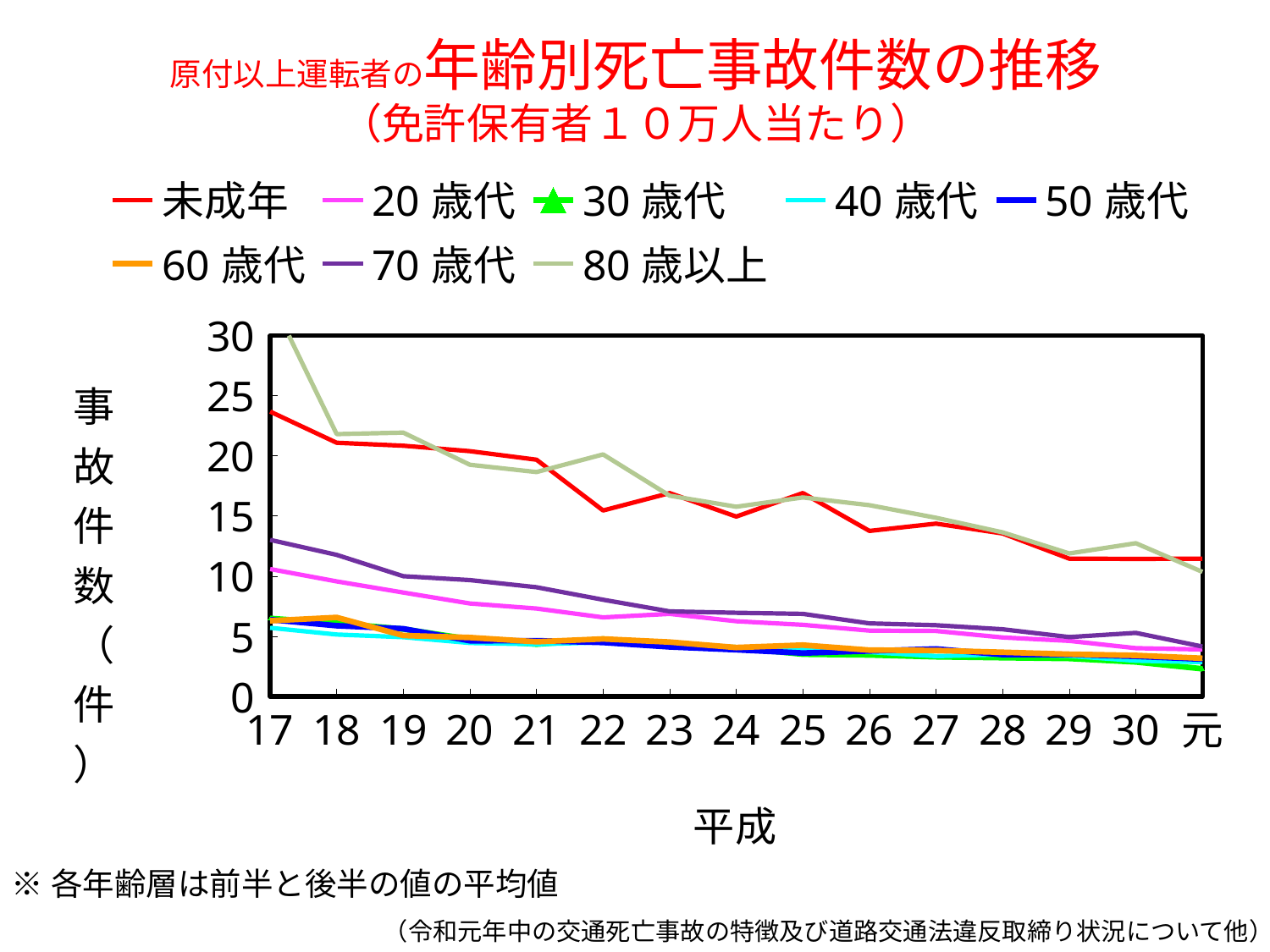
Which is larger at 17, the value for 未成年 or the value for 20歳代? 未成年 How many points are plotted along the x axis for each series? 15 Is the value for 80歳以上 at 17 greater or less than 25? greater Is the value for 70歳代 at 17 greater or less than 10? greater What kind of chart is shown on the slide? line chart Which series has the highest value at 17? 80歳以上 How many series does the legend list? 8 Is the value for 30歳代 at 元 greater or less than 5? less What is the label on the x axis of the chart? 平成 Does the value for 未成年 generally rise or fall from 17 to 元? fall